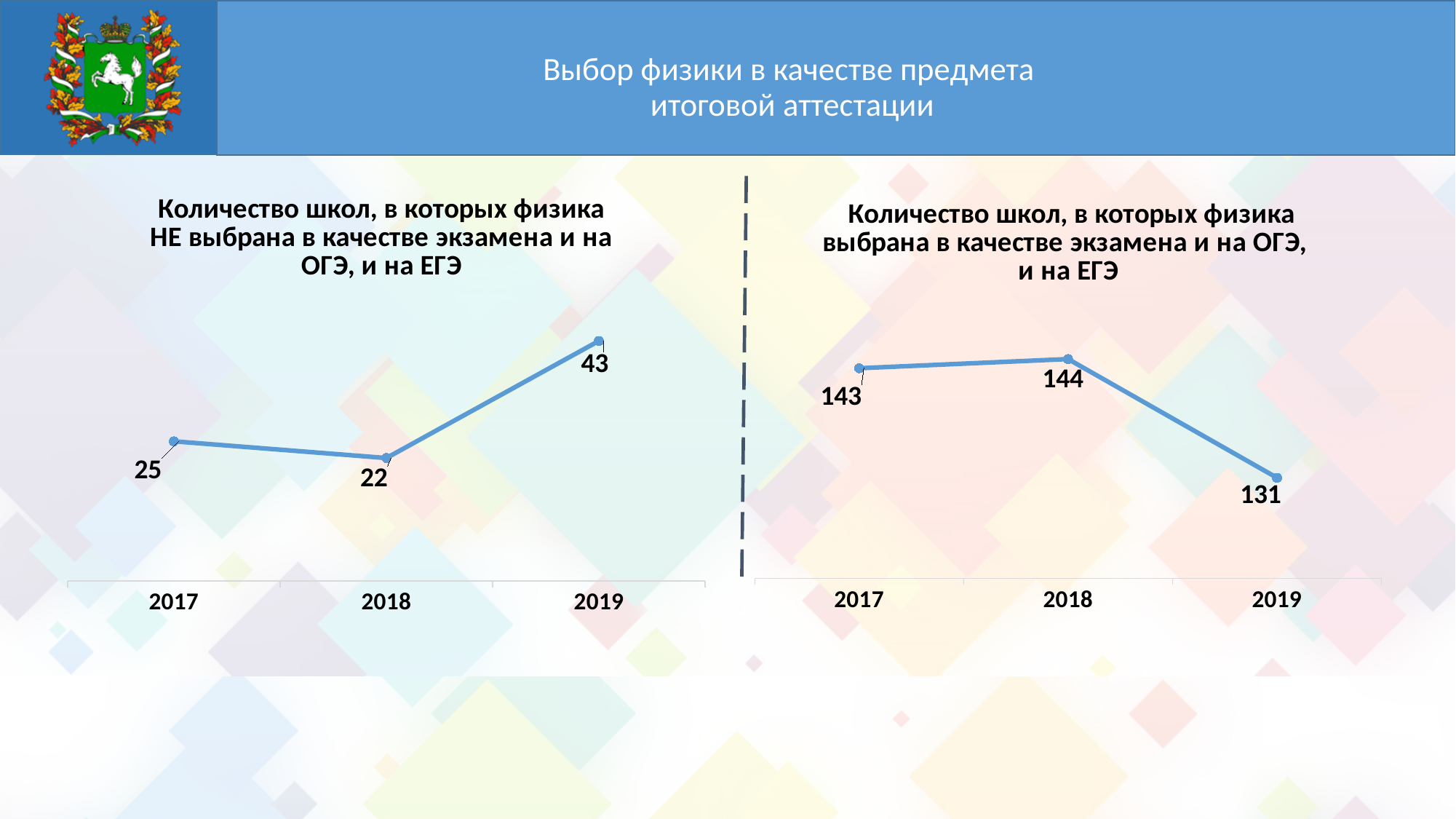
In the right chart (schools where physics is chosen), what is the value for 2019? 131 In the left chart (schools where physics is NOT chosen), what is the difference between the 2019 and 2017 values? 18 In the left chart (schools where physics is NOT chosen for both ОГЭ and ЕГЭ), what is the value for 2019? 43 In the right chart (schools where physics is chosen), what is the difference between the 2018 and 2019 values? 13 What type of chart is used on the right side of the slide (schools where physics is chosen)? Line chart In the left chart (schools where physics is NOT chosen), which year has the lowest value? 2018 How many data points are plotted in the left chart (schools where physics is NOT chosen)? 3 In the right chart (schools where physics is chosen for both ОГЭ and ЕГЭ), what is the value for 2017? 143 In the left chart (schools where physics is NOT chosen), which year has the highest value? 2019 In the left chart (schools where physics is NOT chosen), what is the value for 2018? 22 In the right chart (schools where physics is chosen), which year has the lowest value? 2019 In the right chart (schools where physics is chosen), which is larger: the value for 2017 or the value for 2019? 2017